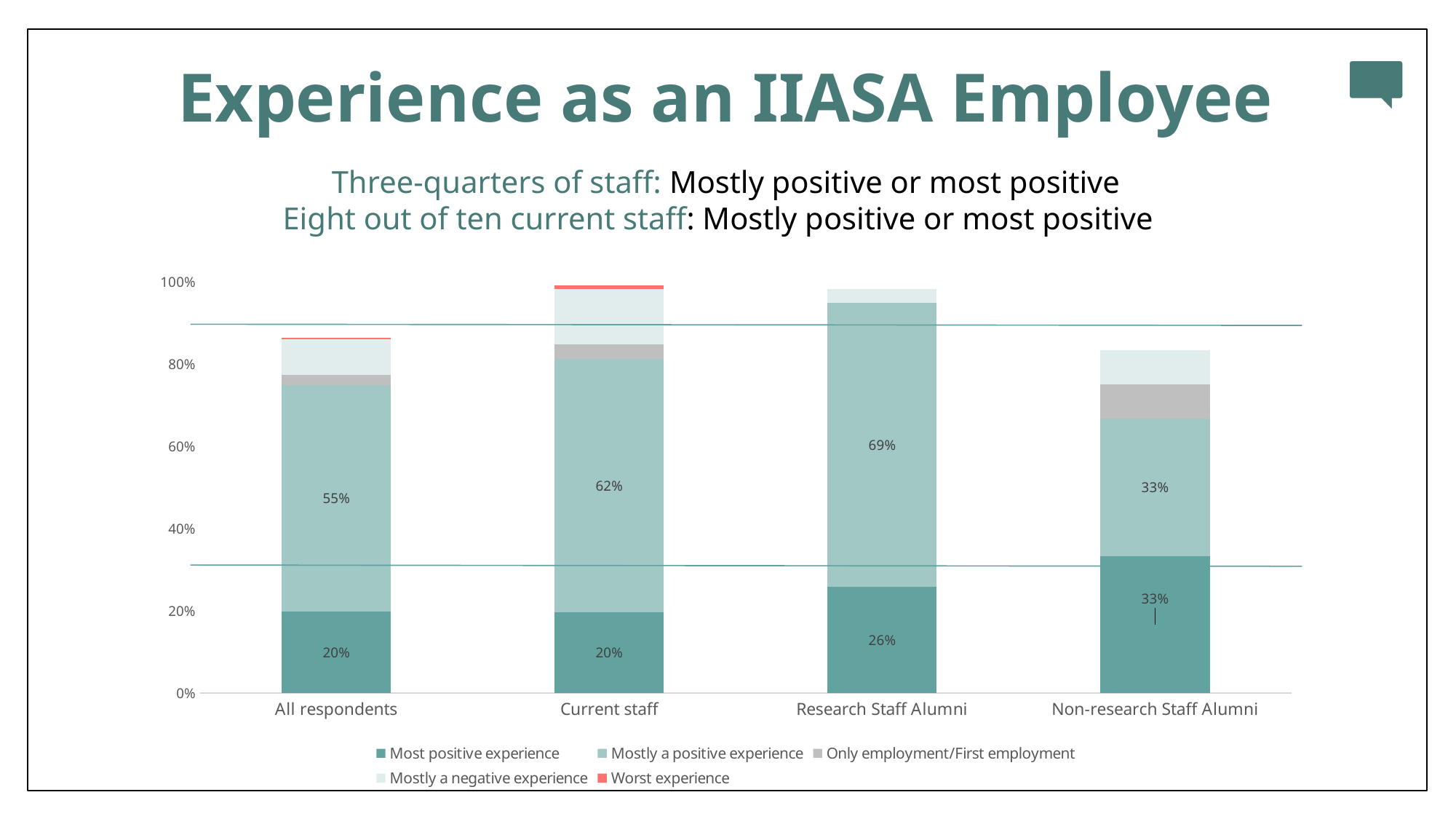
What is the 'Mostly a positive experience' value for Non-research Staff Alumni? 33% Which category has the highest 'Mostly a positive experience' value? Research Staff Alumni How many categories are shown on the x axis? 4 What is the 'Mostly a positive experience' value for Current staff? 62% How many series does the legend list? 5 Which has a larger 'Most positive experience' value: Research Staff Alumni or Current staff? Research Staff Alumni How many percentage points higher is the 'Mostly a positive experience' value for Research Staff Alumni than for Current staff? 7 percentage points What percentage of Research Staff Alumni reported the 'Most positive experience'? 26% Which category has the highest 'Most positive experience' value? Non-research Staff Alumni Which category has the lowest 'Mostly a positive experience' value? Non-research Staff Alumni Is the total height of the stacked bar for Non-research Staff Alumni greater or less than 90%? less What is the 'Most positive experience' value for All respondents? 20%